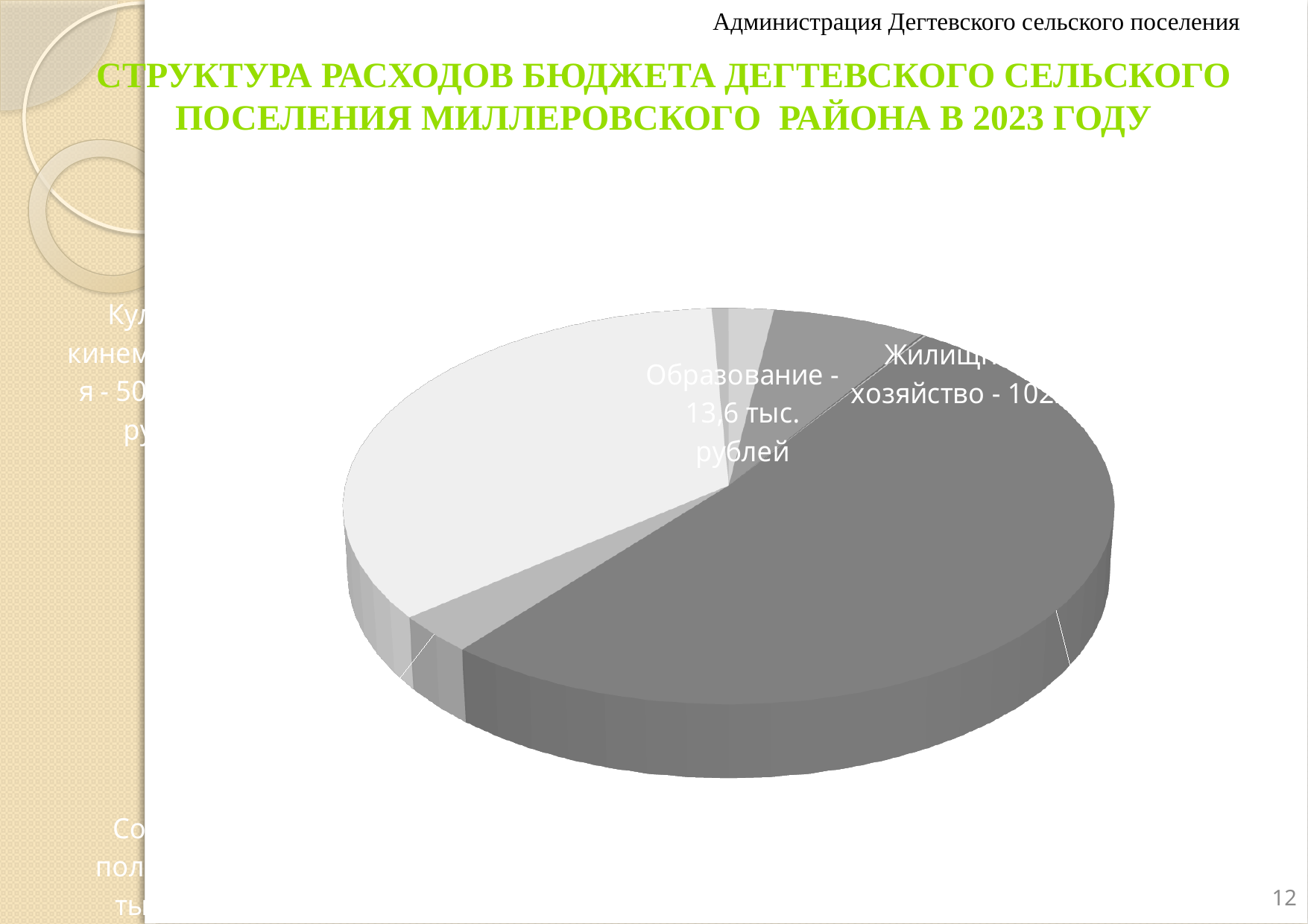
What value is shown for Образование in the pie chart? 13,6 тыс. рублей What kind of chart is shown on the slide? pie chart Which year does the chart title say the budget expenditure structure refers to? 2023 Which settlement's budget expenditure structure does the chart title refer to? Дегтевское сельское поселение